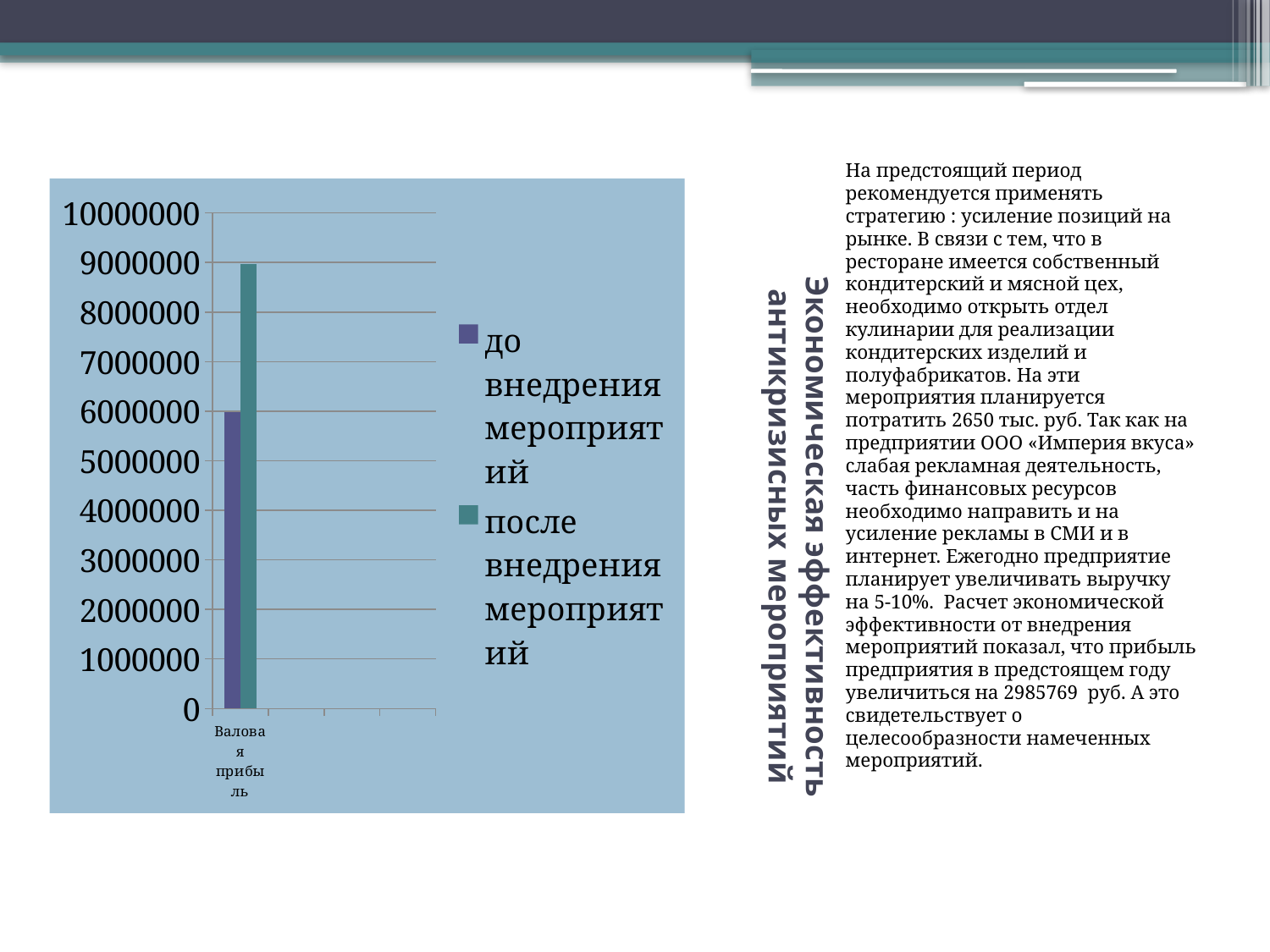
Which series shows the highest bar in the chart? после внедрения мероприятий Is the value for 'после внедрения мероприятий' greater or less than 10000000? less How many series does the chart legend list? 2 What is the category label shown on the x axis of the chart? Валовая прибыль How many categories are plotted on the x axis of the chart? 1 Is the value for 'до внедрения мероприятий' greater or less than 7000000? less Is the value for 'до внедрения мероприятий' greater or less than 5000000? greater What kind of chart is shown on the slide? bar chart What is the highest tick value shown on the vertical axis of the chart? 10000000 Which series has the higher value for Валовая прибыль: 'до внедрения мероприятий' or 'после внедрения мероприятий'? после внедрения мероприятий Which series shows the lowest bar in the chart? до внедрения мероприятий